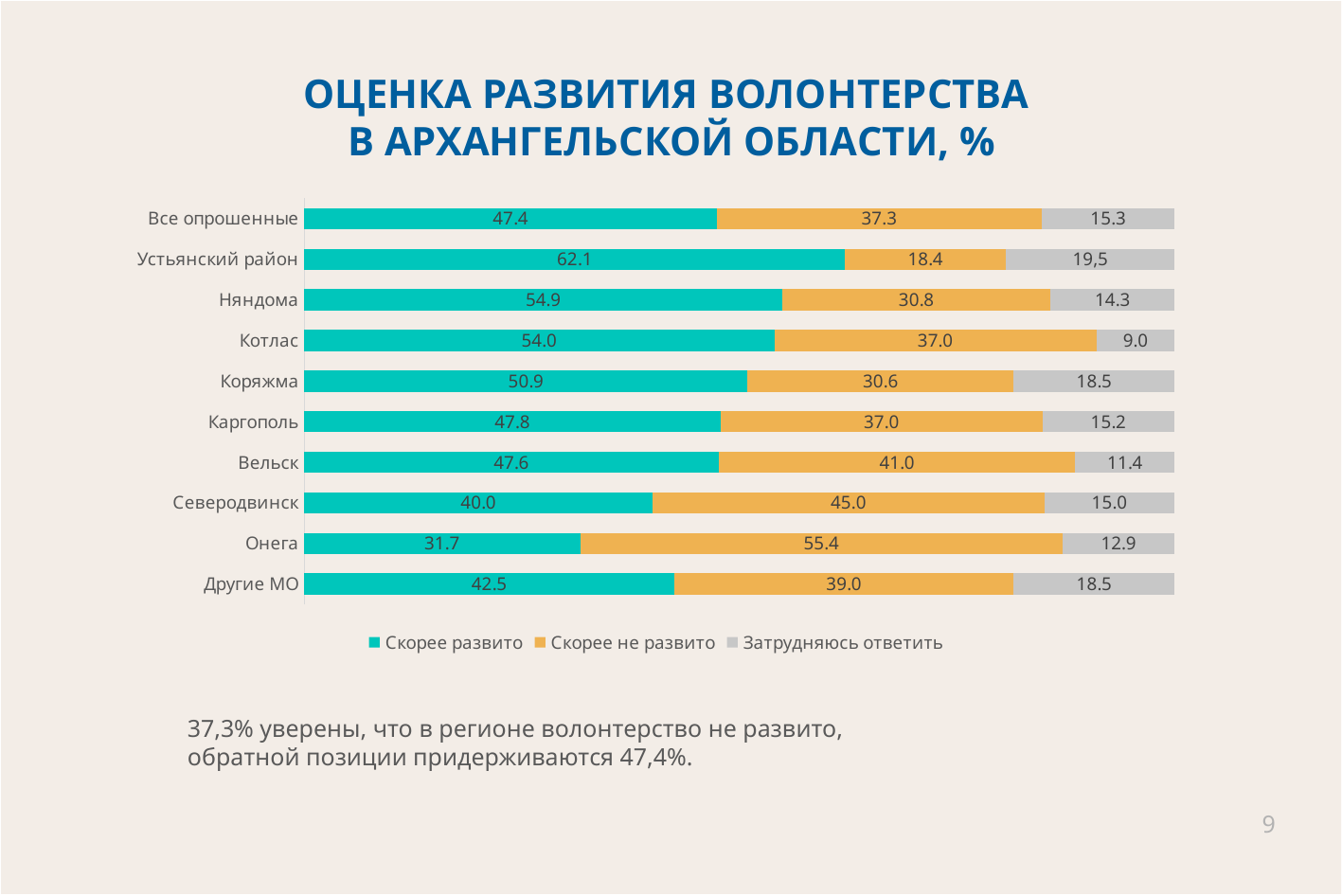
How many series does the legend list? 3 What is the value of 'Затрудняюсь ответить' for Устьянский район? 19,5 How many categories are shown on the chart? 10 What is the difference between 'Скорее развито' and 'Скорее не развито' for Все опрошенные? 10.1 For Северодвинск, which is larger: 'Скорее развито' or 'Скорее не развито'? Скорее не развито Which category has the lowest value for 'Затрудняюсь ответить'? Котлас Which category has the highest value for 'Скорее развито'? Устьянский район What is the total of the stacked bar for Котлас? 100.0 What is the value of 'Скорее не развито' for Онега? 55.4 What is the value of 'Скорее развито' for Устьянский район? 62.1 Which category has the lowest value for 'Скорее развито'? Онега What type of chart is shown on the slide? Stacked bar chart